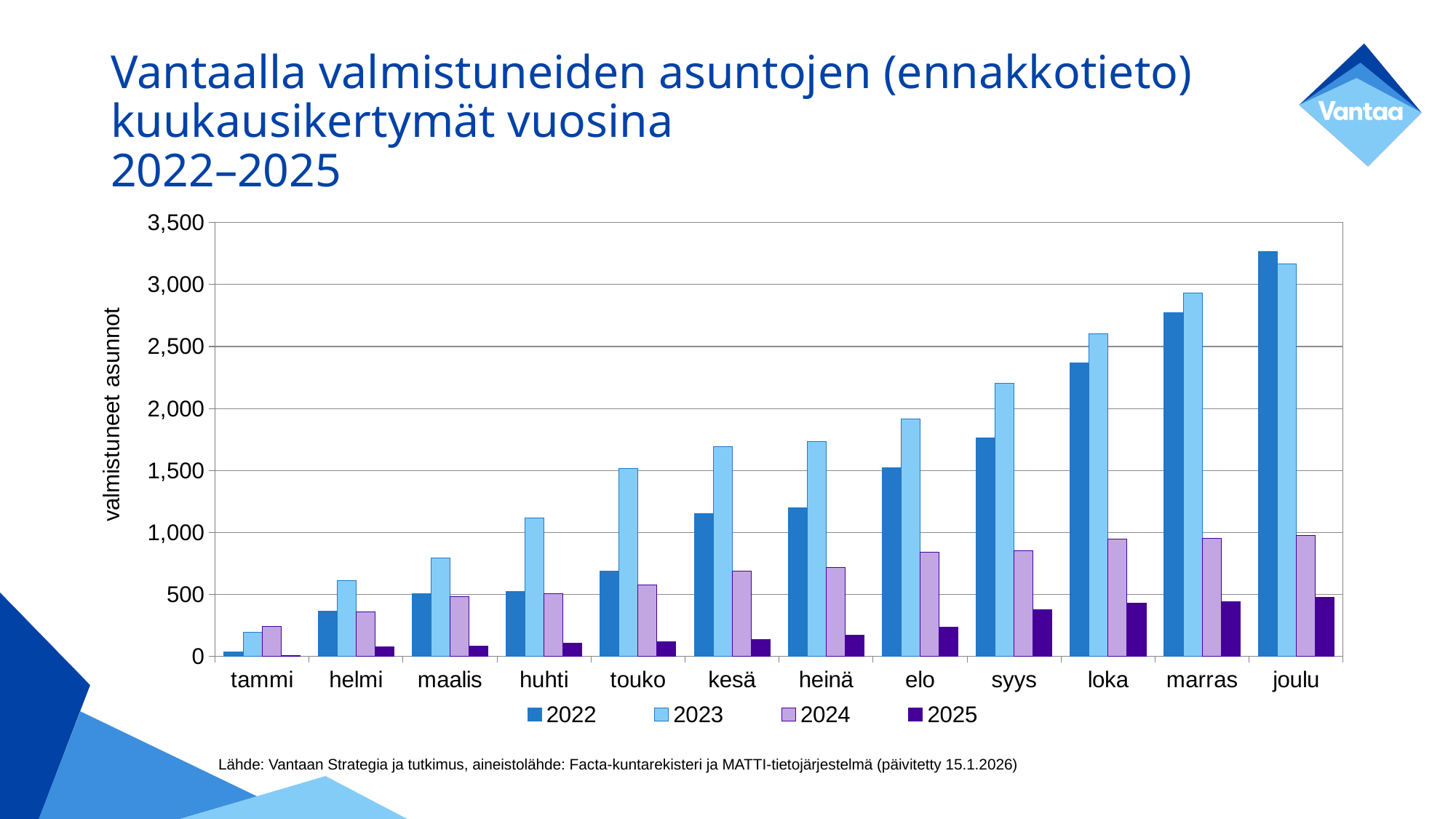
In kesä, which series has the larger value, 2024 or 2025? 2024 Is the value for 2024 in loka greater or less than 1,000? less How many months are shown on the x axis? 12 What kind of chart is shown on the slide? bar chart In syys, which series has the larger value, 2022 or 2023? 2023 Is the value for 2023 in joulu greater or less than 3,000? greater Which month has the lowest value for the 2022 series? tammi Do the values for the 2023 series rise or fall from tammi to joulu? rise Is the value for 2022 in loka greater or less than 2,500? less Which month has the highest value for the 2025 series? joulu How many series does the legend list? 4